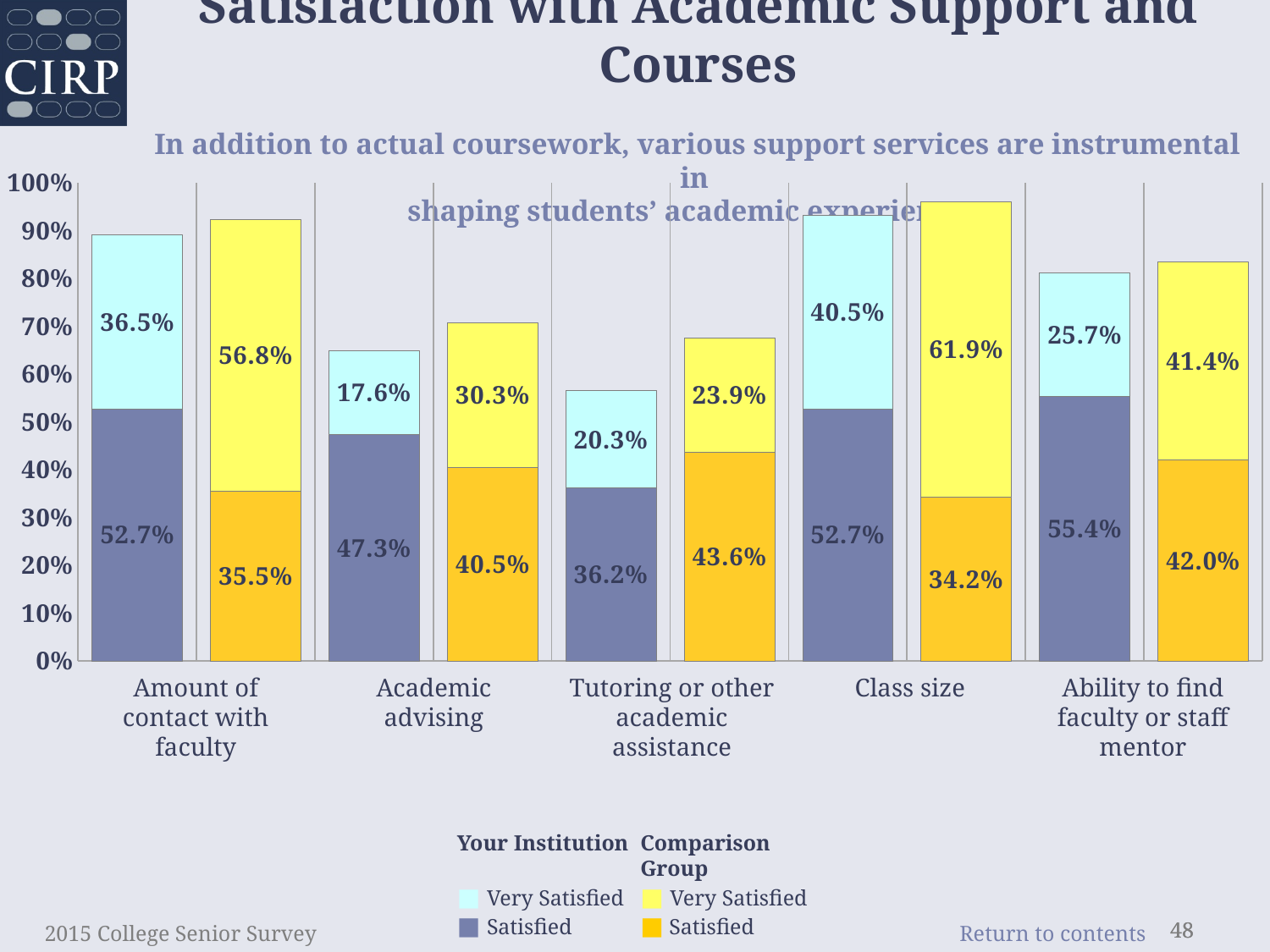
What percentage of the Comparison Group was Satisfied with tutoring or other academic assistance? 43.6% What percentage of Your Institution students were Satisfied with the amount of contact with faculty? 52.7% What percentage of Your Institution students were Very Satisfied with academic advising? 17.6% What is the difference between the Comparison Group's and Your Institution's Very Satisfied percentages for ability to find faculty or staff mentor? 15.7% What is the combined Satisfied and Very Satisfied percentage for the Comparison Group on academic advising? 70.8% What percentage of the Comparison Group was Very Satisfied with class size? 61.9% For class size, which is larger: Your Institution's Satisfied percentage or the Comparison Group's Satisfied percentage? Your Institution Which category has the lowest Very Satisfied percentage for Your Institution? Academic advising Which category has the highest Very Satisfied percentage for the Comparison Group? Class size What kind of chart is shown on the slide? Stacked bar chart What is the combined Satisfied and Very Satisfied percentage for Your Institution on class size? 93.2% How many categories are shown on the x axis of the chart? 5